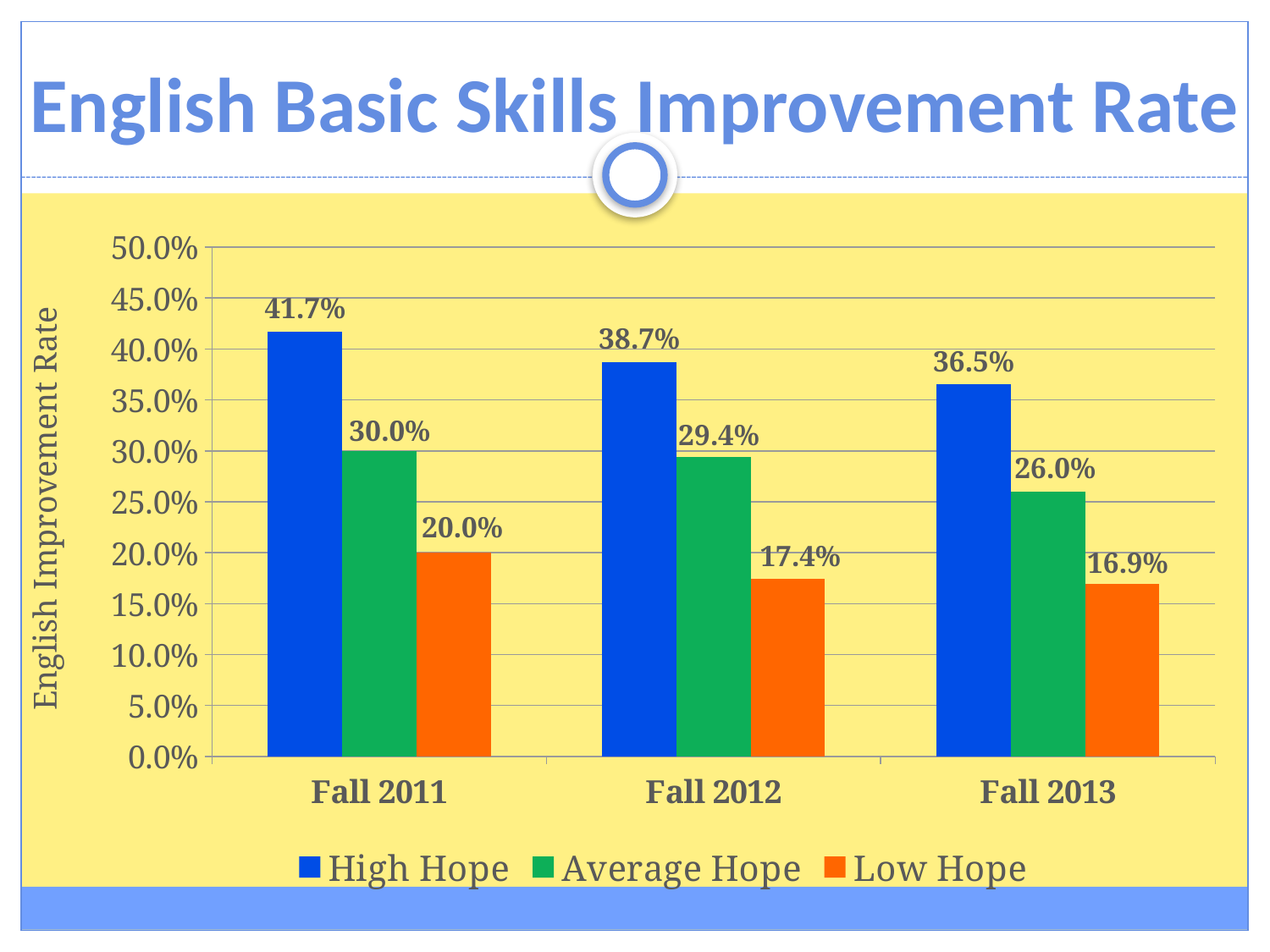
Is the High Hope value for Fall 2013 greater or less than 40.0%? less In which term is the Low Hope improvement rate lowest? Fall 2013 What kind of chart is shown on the slide? bar chart Do the High Hope values rise or fall from Fall 2011 to Fall 2013? fall Which is larger: the Average Hope rate in Fall 2012 or the Average Hope rate in Fall 2013? Fall 2012 What is the English Improvement Rate for High Hope in Fall 2011? 41.7% How many terms are shown on the x axis? 3 What is the difference between the High Hope and Low Hope rates in Fall 2011? 21.7% What is the English Improvement Rate for Low Hope in Fall 2012? 17.4% In which term is the High Hope improvement rate highest? Fall 2011 What is the English Improvement Rate for Average Hope in Fall 2013? 26.0% How many series does the legend list? 3